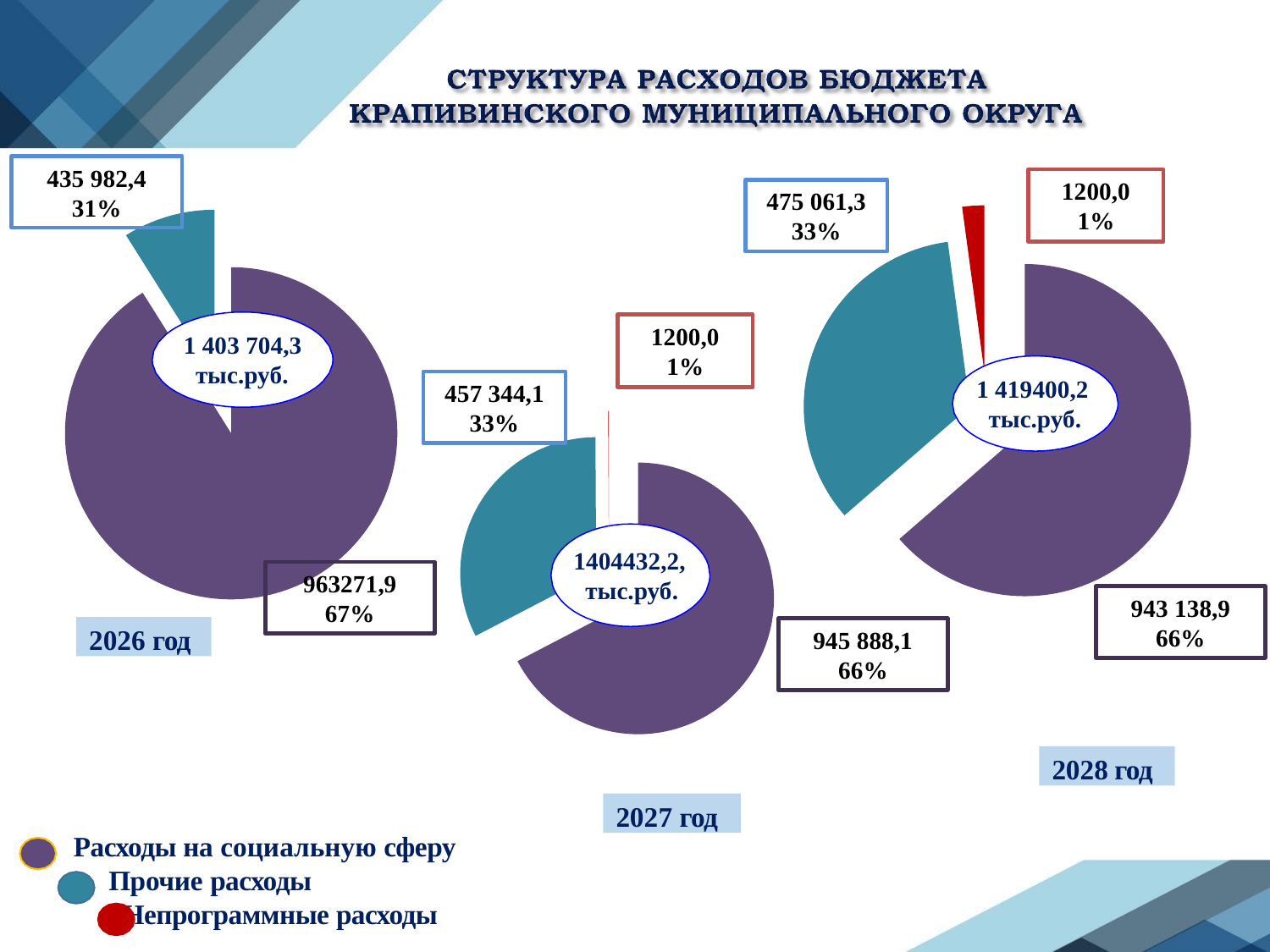
In the 2027 год pie chart, what share of the pie is Непрограммные расходы? 1% What type of charts are shown on the slide? Pie charts In the 2028 год pie chart, which category is the largest? Расходы на социальную сферу In the 2027 год pie chart, what is the value for Прочие расходы? 457 344,1 How many categories does the legend list? 3 How many pie charts are on the slide? 3 In the 2028 год pie chart, which category is the smallest? Непрограммные расходы In the 2026 год pie chart, what is the value for Расходы на социальную сферу? 963271,9 In the 2028 год pie chart, what is the value for Расходы на социальную сферу? 943 138,9 Which is larger: Прочие расходы in 2027 год or Прочие расходы in 2028 год? 2028 год What total is shown in the centre of the 2027 год pie chart? 1404432,2 тыс.руб. In the 2026 год pie chart, what share of the pie is Прочие расходы? 31%